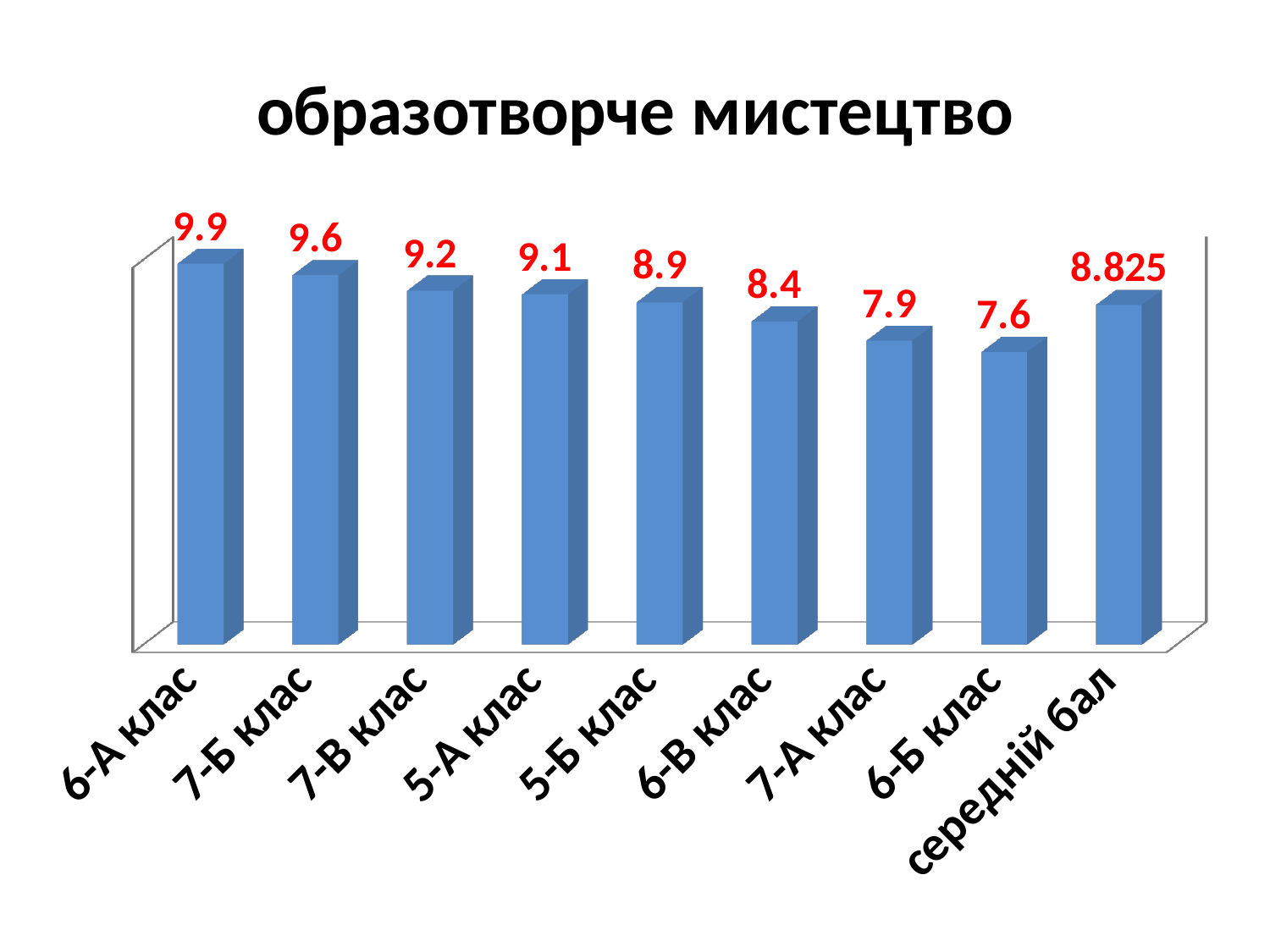
What is the title of the chart? образотворче мистецтво What is the value for 7-В клас? 9.2 Which category has the highest value? 6-А клас What is the difference between the values for 7-Б клас and 7-А клас? 1.7 Do the values for the classes rise or fall from left to right across the first eight bars? fall Which class has the lowest value? 6-Б клас What is the value for середній бал? 8.825 What is the value for 6-А клас? 9.9 What kind of chart is shown on the slide? bar chart How many bars are shown in the chart? 9 What is the difference between the values for 6-А клас and 6-Б клас? 2.3 Which is larger, the value for 5-А клас or the value for 6-В клас? 5-А клас